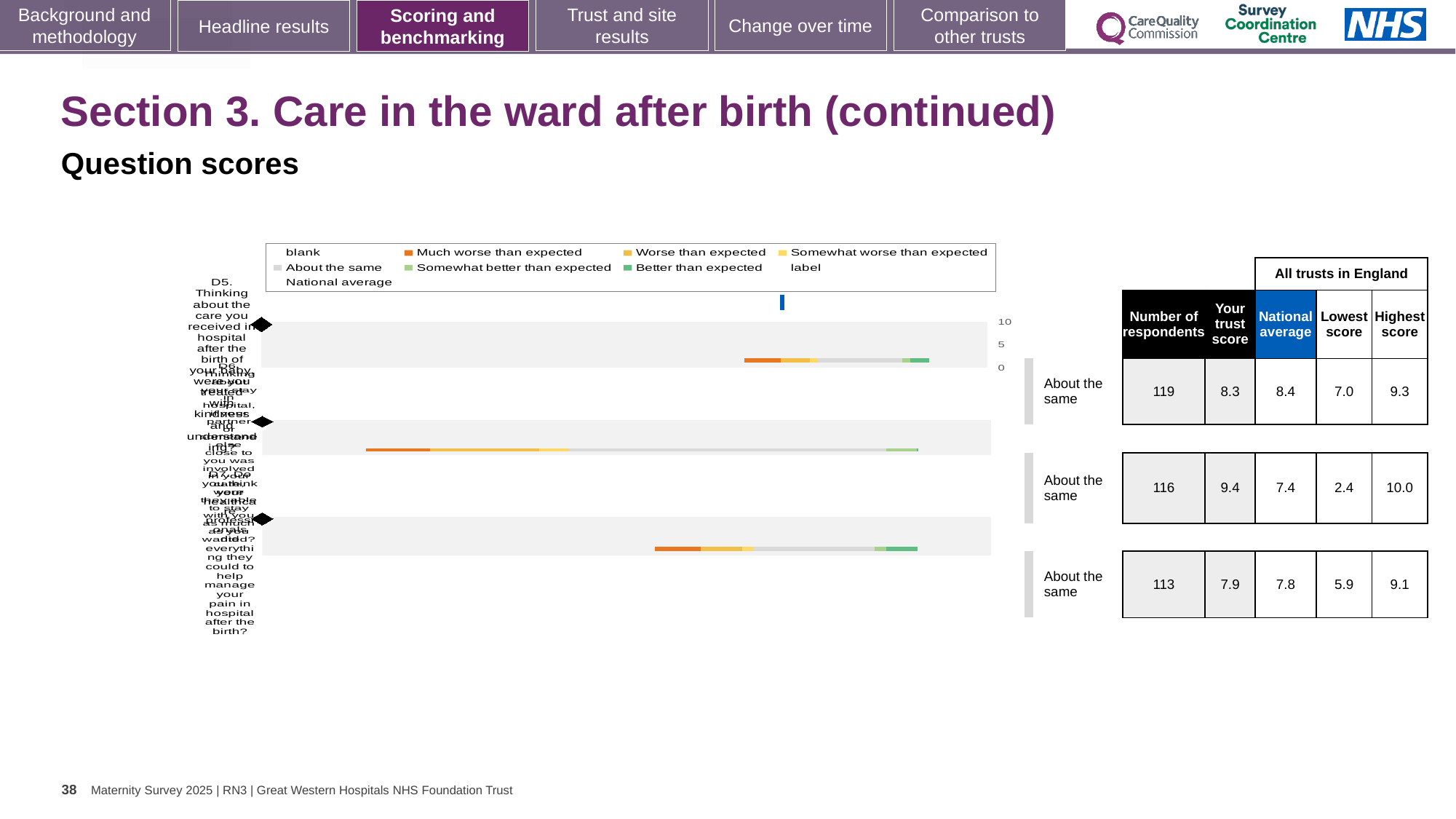
In the table beside the chart, which row has the highest 'Your trust score'? the second row (D6), 9.4 In the table beside the chart, what is the difference between the trust score and the national average for the second row (D6)? 2.0 How many bars (question rows) does the chart show? 3 In the table beside the chart, what is the lowest score for the second row (D6)? 2.4 In the table beside the chart, what is the 'Your trust score' for the second row (D6)? 9.4 What is the highest tick value shown on the chart's axis? 10 In the table beside the chart, what is the number of respondents for the first row (D5)? 119 In the table beside the chart, what is the national average for the third row (D7)? 7.8 What kind of chart is shown on the slide? bar chart Which legend entry is shown in dark orange? Much worse than expected In the table beside the chart, is the trust score for the first row (D5) higher or lower than the national average? lower How many entries does the chart's legend list? 9